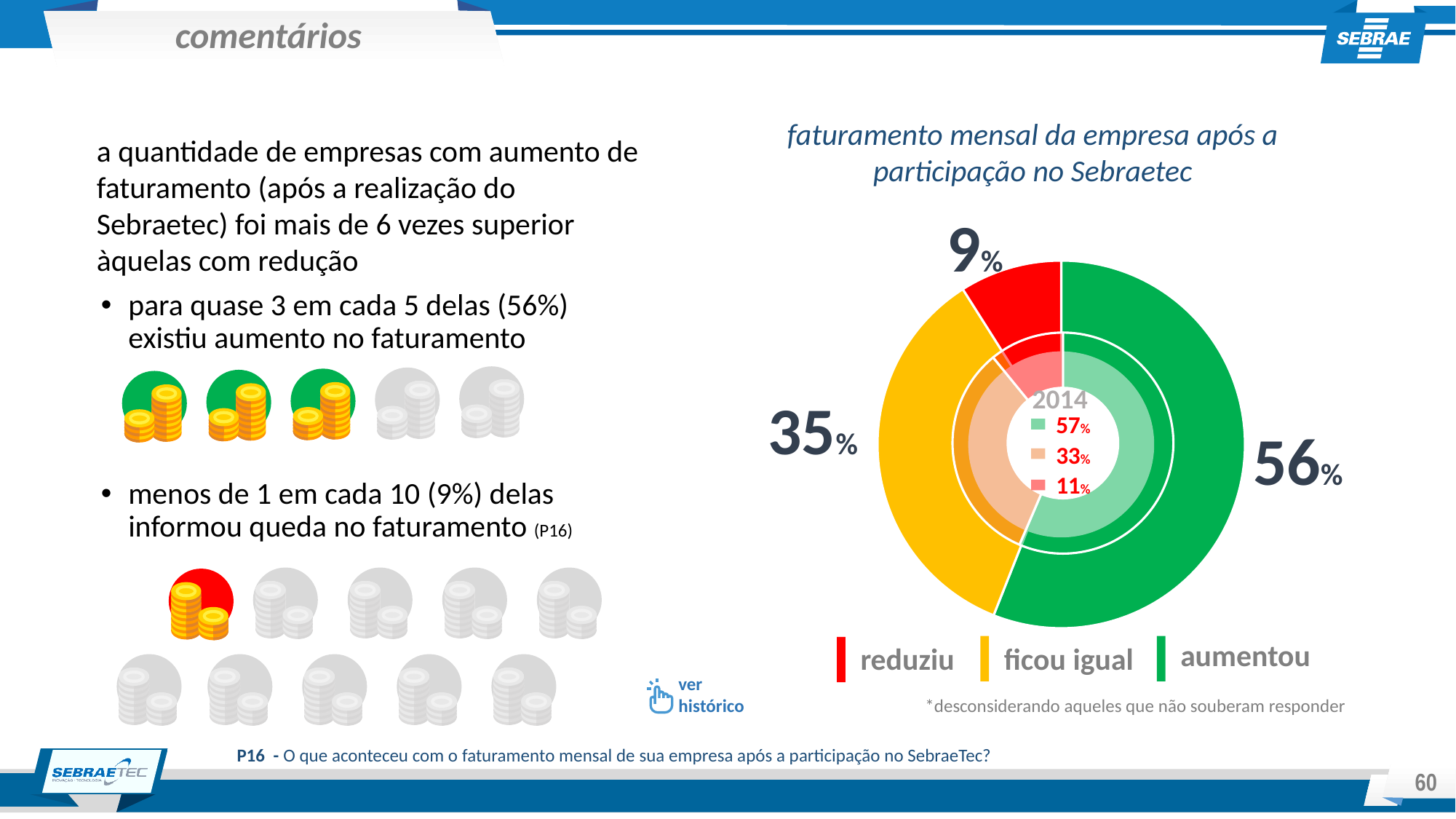
How many categories does the legend of the donut chart list? 3 What type of chart is used to show the monthly revenue after participation in Sebraetec? Donut (pie) chart What share of companies reported that their monthly revenue decreased ("reduziu") in the outer ring of the donut chart? 9% In the inner 2014 ring of the donut chart, what share corresponds to "ficou igual" (orange)? 33% Which category has the largest share in the outer ring of the donut chart? aumentou In the inner 2014 ring of the donut chart, what share corresponds to "reduziu" (red)? 11% What share of companies reported that their monthly revenue stayed the same ("ficou igual") in the outer ring of the donut chart? 35% In the inner 2014 ring of the donut chart, what share corresponds to "aumentou" (green)? 57% What is the difference in percentage points between "aumentou" and "reduziu" in the outer ring of the donut chart? 47 What share of companies reported that their monthly revenue increased ("aumentou") in the outer ring of the donut chart? 56% Which is larger in the outer ring of the donut chart: "ficou igual" or "reduziu"? ficou igual Which category has the smallest share in the outer ring of the donut chart? reduziu